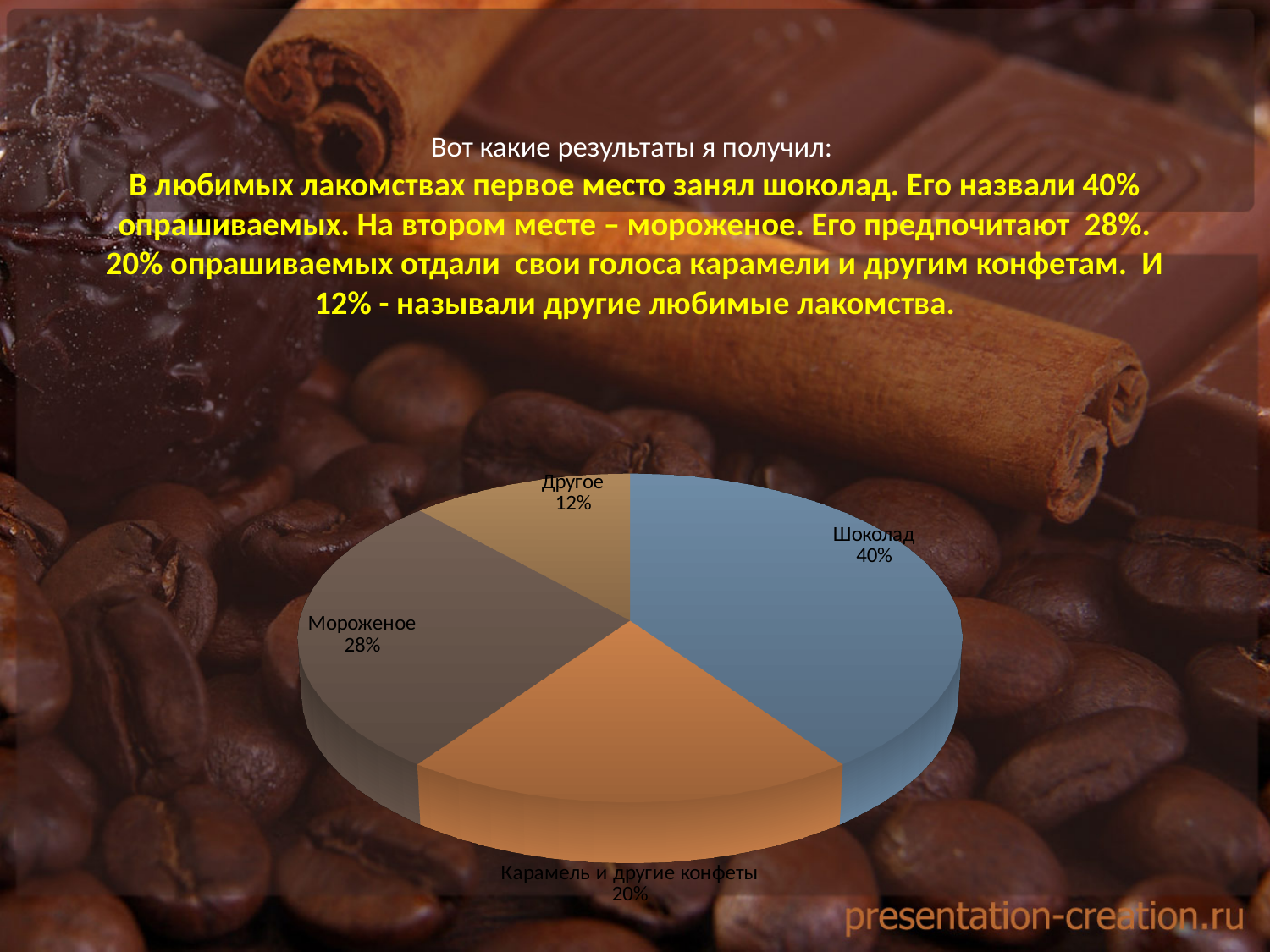
What share of the pie does Мороженое have? 28% Which slice of the pie is the smallest? Другое What share of the pie does Другое have? 12% What share of the pie does Карамель и другие конфеты have? 20% What colour is the Шоколад slice of the pie? blue How many slices does the pie chart have? 4 What is the difference in percentage points between Карамель и другие конфеты and Другое? 8 What is the difference in percentage points between Шоколад and Мороженое? 12 What kind of chart is shown on the slide? pie chart Which slice of the pie is the largest? Шоколад Which is larger, the share for Мороженое or the share for Карамель и другие конфеты? Мороженое What share of the pie does Шоколад have? 40%